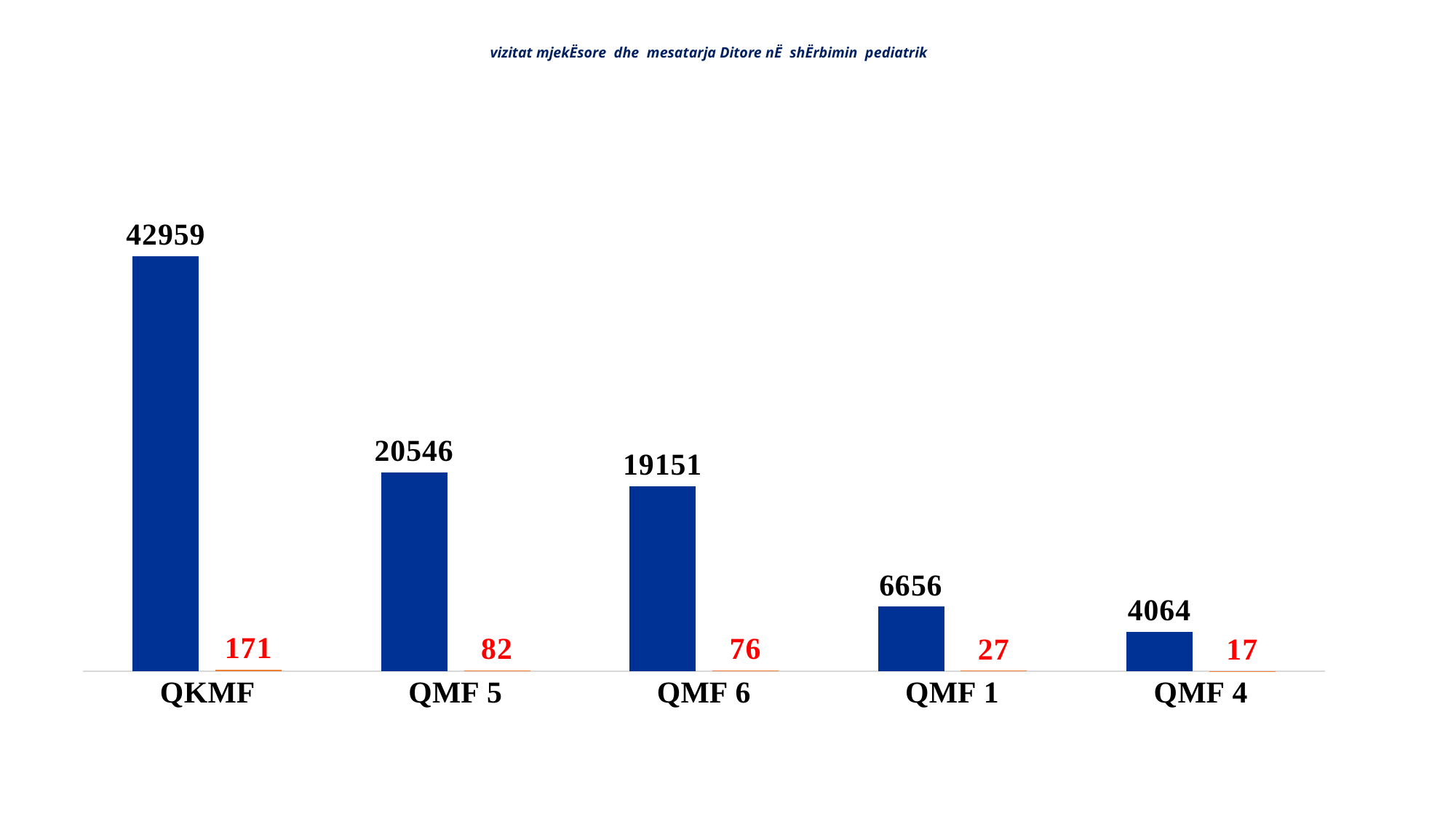
What is the title of the chart? vizitat mjekËsore dhe mesatarja Ditore nË shËrbimin pediatrik What is the value shown on the blue bar for QKMF? 42959 What is the red-labelled value shown for QMF 6? 76 What is the difference between the blue bar values for QMF 5 and QMF 6? 1395 Which has a larger blue bar value, QMF 1 or QMF 4? QMF 1 How many categories are shown on the x axis? 5 Do the blue bar values rise or fall from left to right along the x axis? Fall What kind of chart is shown on the slide? Bar chart What is the difference between the red-labelled values for QKMF and QMF 4? 154 Which category has the highest blue bar? QKMF What is the red-labelled value shown for QMF 5? 82 Which category has the lowest blue bar? QMF 4